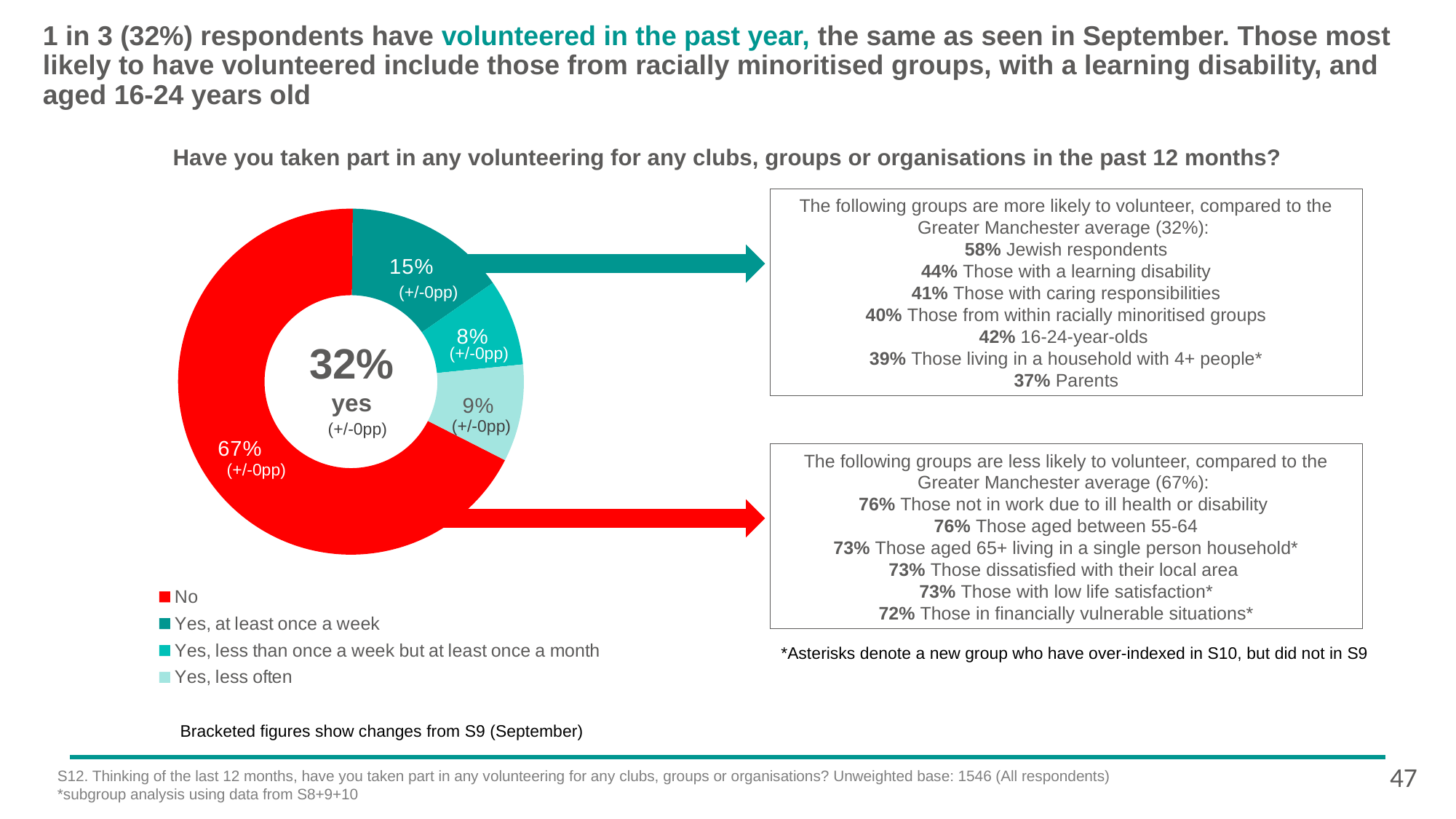
Which is larger: the share for "Yes, less often" or the share for "Yes, less than once a week but at least once a month"? Yes, less often What is the difference in percentage points between "No" and "Yes, at least once a week"? 52 percentage points What is the combined percentage of all "Yes" responses shown in the centre of the donut chart? 32% What percentage of respondents volunteered less often? 9% What percentage of respondents volunteered less than once a week but at least once a month? 8% Which category has the smallest share of the donut chart? Yes, less than once a week but at least once a month What colour is used for the "No" slice of the donut chart? Red What percentage of respondents volunteered at least once a week? 15% How many categories does the donut chart legend list? 4 What kind of chart is shown on the slide? Donut (pie) chart Which category has the largest share of the donut chart? No What percentage of respondents answered "No" to volunteering in the past 12 months? 67%